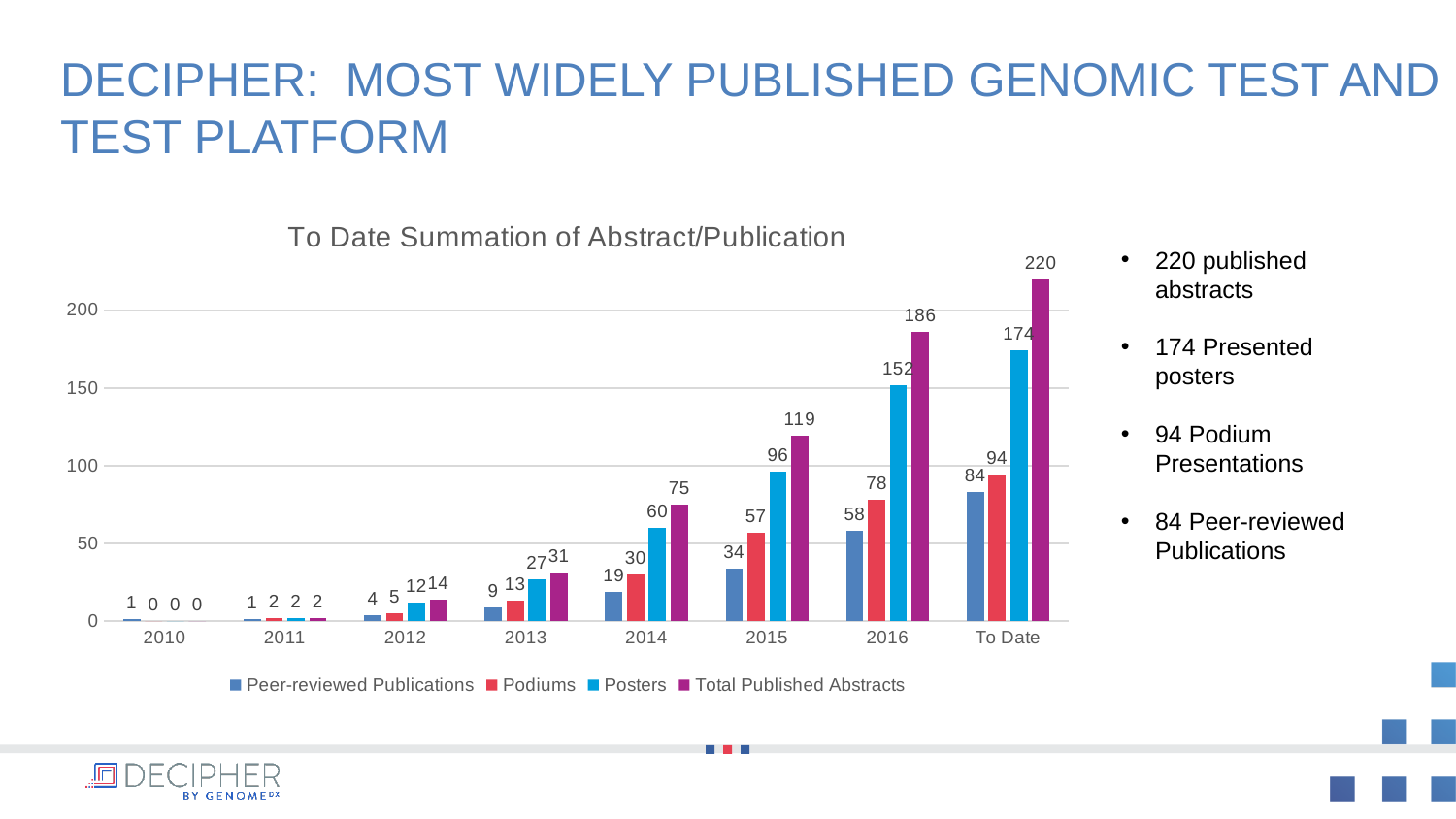
How many categories are shown on the x axis of the chart? 8 What is the difference between Posters and Podiums for 2016? 74 Do the Total Published Abstracts values rise or fall from 2010 to To Date? Rise What is the title of the chart? To Date Summation of Abstract/Publication What type of chart is shown on the slide? Bar chart What is the value of Peer-reviewed Publications for 2014? 19 Which is larger for 2013: Podiums or Posters? Posters What is the value of Posters for 2015? 96 Which category has the highest value for Total Published Abstracts? To Date What is the value of Total Published Abstracts for 2016? 186 How many series does the chart legend list? 4 What is the value of Podiums for To Date? 94